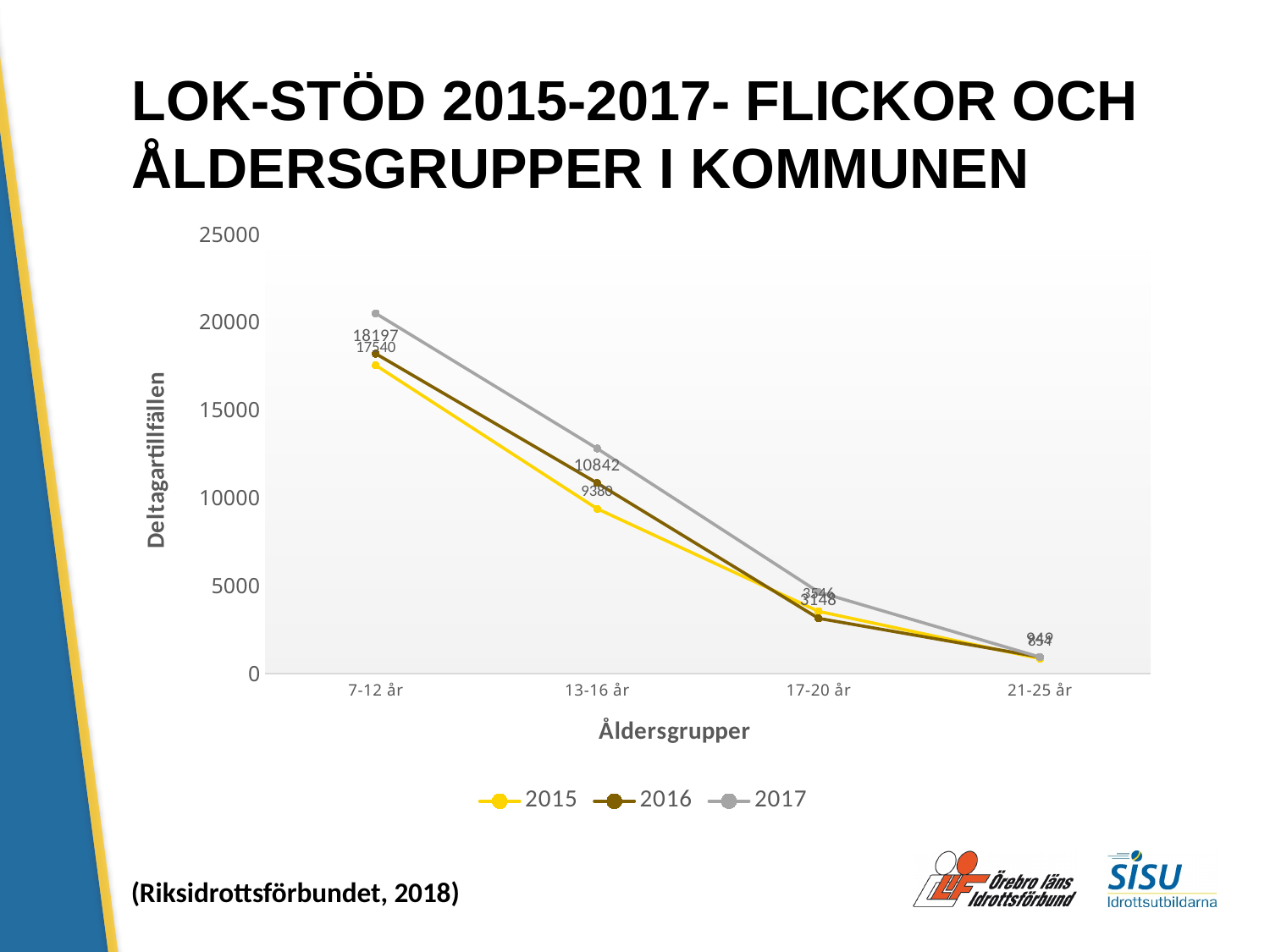
What is the label on the y axis? Deltagartillfällen What is the value for 2016 in the 13-16 år age group? 10842 What is the value for 2015 in the 13-16 år age group? 9380 Which age group has the highest value for 2017? 7-12 år In the 13-16 år age group, which is larger: the value for 2015 or for 2017? 2017 Is the value for 2017 in the 13-16 år age group greater or less than 10000? greater Do the values for 2017 rise or fall from 7-12 år to 21-25 år? fall Is the value for 2017 in the 7-12 år age group greater or less than 20000? greater How many age groups are shown on the x axis? 4 What kind of chart is shown on the slide? line chart How many series does the legend list? 3 What is the value for 2016 in the 7-12 år age group? 18197